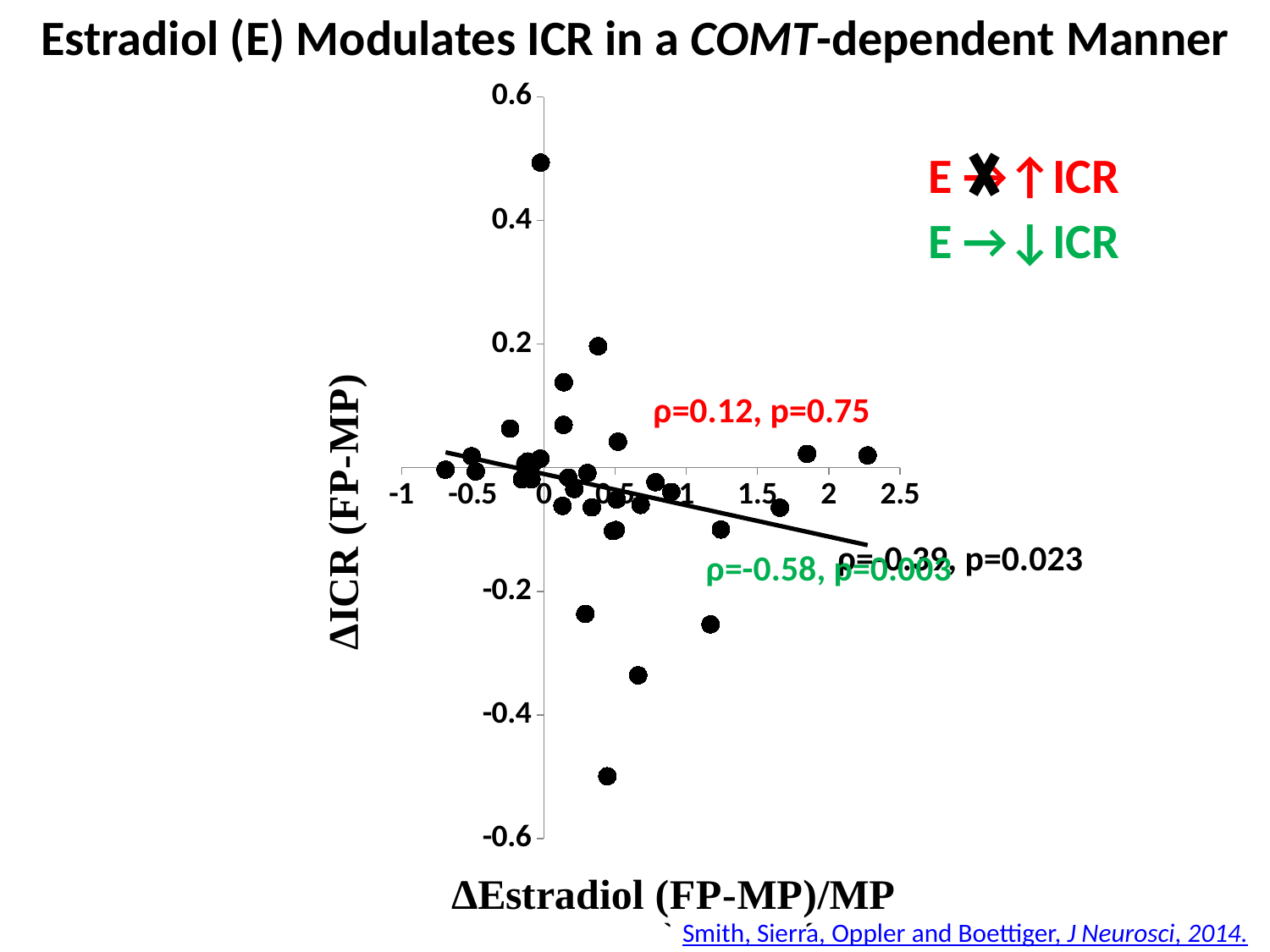
Does the fitted trend line rise or fall as ΔEstradiol increases along the x axis? fall What correlation coefficient and p-value are printed in red on the chart? ρ=0.12, p=0.75 What is the label of the x axis? ΔEstradiol (FP-MP)/MP What is the maximum value shown on the y axis? 0.6 Is the ΔICR value of the lowest point on the chart greater or less than -0.4? less What correlation coefficient and p-value are printed in green on the chart? ρ=-0.58, p=0.003 What is the maximum value shown on the x axis? 2.5 What is the title of the slide's chart? Estradiol (E) Modulates ICR in a COMT-dependent Manner What kind of chart is shown on the slide? scatter plot Is the ΔICR value of the highest point on the chart greater or less than 0.4? greater Is the ΔEstradiol value of the rightmost point on the chart greater or less than 2? greater What is the minimum value shown on the y axis? -0.6